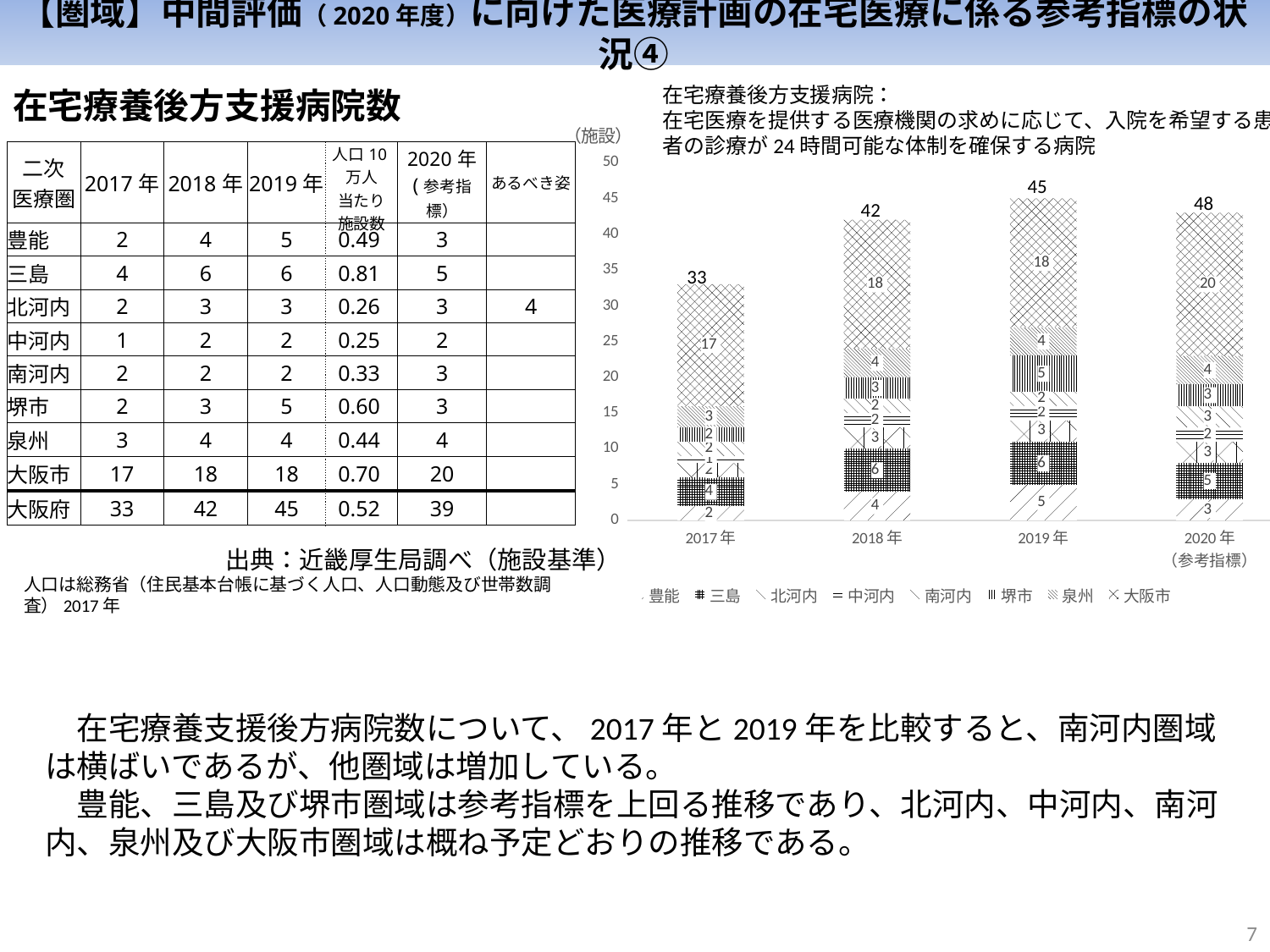
In the chart, what is the value of the 大阪市 segment for 2020年（参考指標）? 20 What is the total shown above the 2020年（参考指標） bar in the chart? 48 In the chart, what is the value of the 堺市 segment for 2019年? 5 What is the total shown above the 2017年 bar in the chart? 33 Which year has the lowest total in the chart? 2017年 What type of chart is shown on the slide? stacked bar chart Do the bar totals rise or fall from 2017年 to 2020年（参考指標） in the chart? rise What is the total shown above the 2019年 bar in the chart? 45 How many bars (years) are plotted in the chart? 4 Which year has the highest total in the chart? 2020年（参考指標） How many series does the chart legend list? 8 What is the difference between the 2018年 total and the 2017年 total in the chart? 9